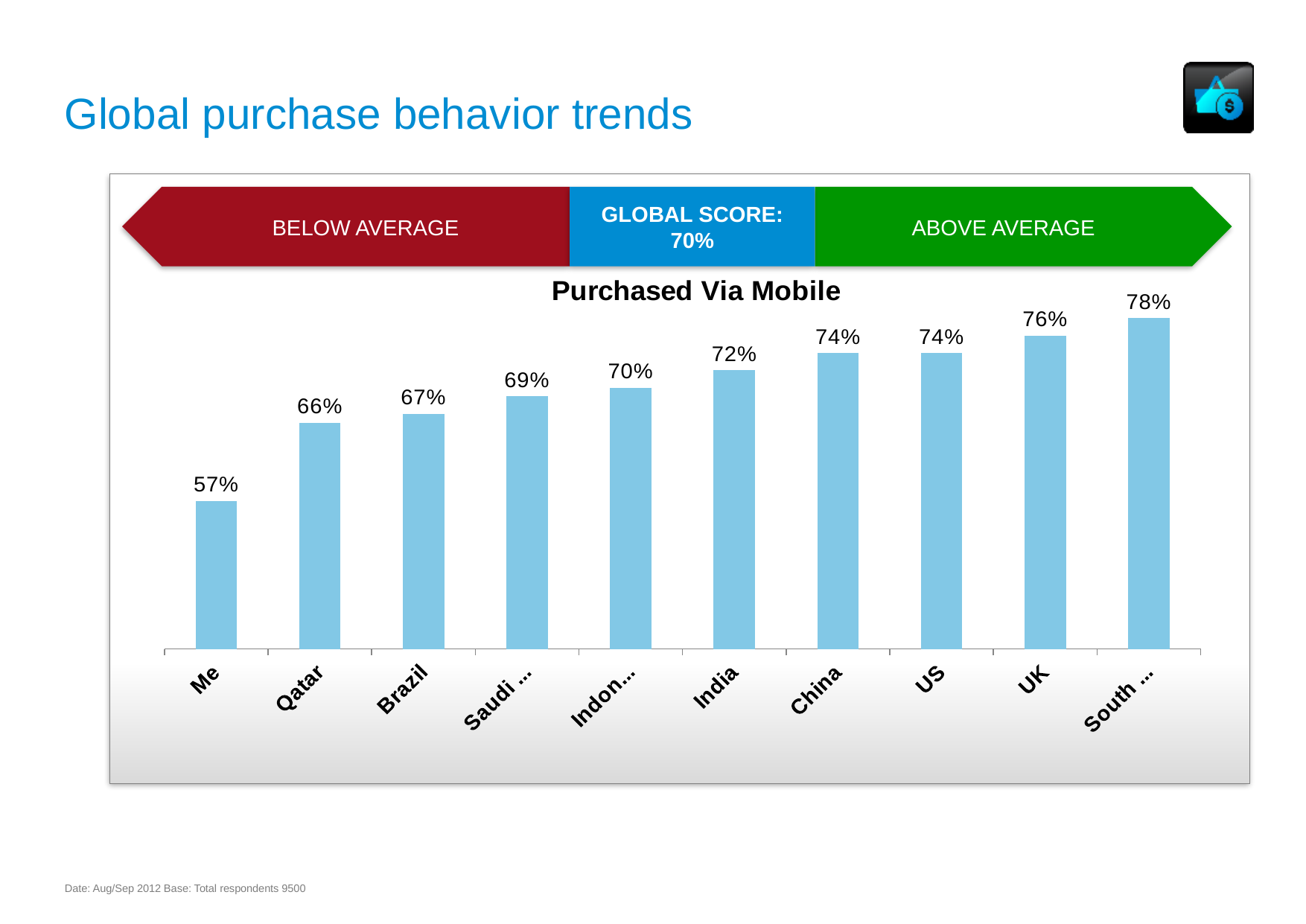
What global score is shown in the banner above the Purchased Via Mobile chart? 70% What is the value for UK in the Purchased Via Mobile chart? 76% What is the highest value shown in the Purchased Via Mobile chart? 78% What is the value for Qatar in the Purchased Via Mobile chart? 66% How many bars are shown in the Purchased Via Mobile chart? 10 What is the value for Brazil in the Purchased Via Mobile chart? 67% What is the value for India in the Purchased Via Mobile chart? 72% What is the difference between the values for UK and Qatar in the Purchased Via Mobile chart? 10% Do the values in the Purchased Via Mobile chart generally rise or fall from left to right? Rise What kind of chart is the Purchased Via Mobile chart? Bar chart Which category has the lowest value in the Purchased Via Mobile chart? Me Which is larger in the Purchased Via Mobile chart, the value for China or the value for Brazil? China